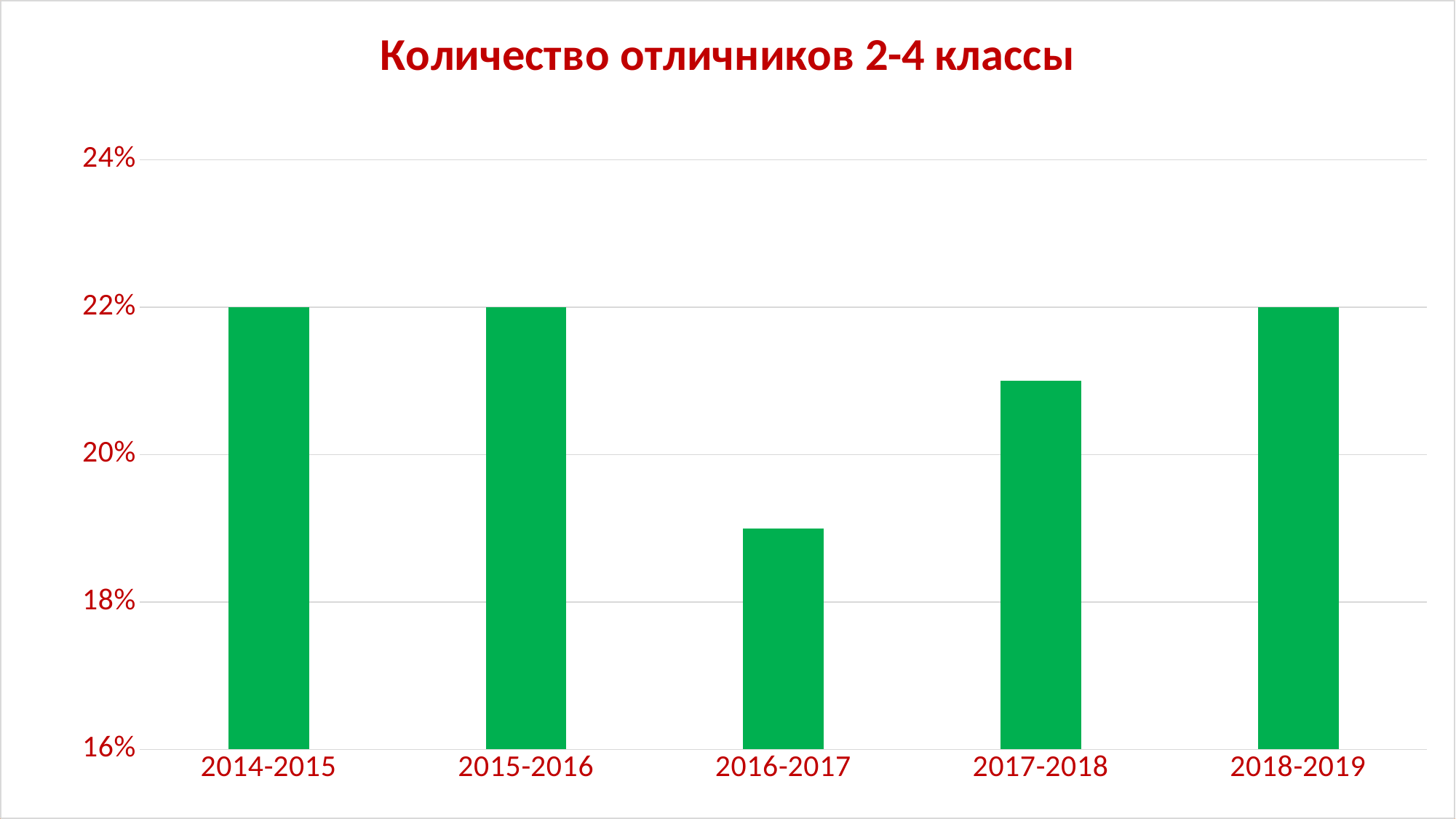
Which school year has the lowest value? 2016-2017 What is the value for 2018-2019? 22% How many school years are shown on the x axis? 5 What is the value for 2015-2016? 22% Which is larger, the value for 2015-2016 or the value for 2016-2017? 2015-2016 Is the value for 2016-2017 greater or less than 20%? less What type of chart is shown on the slide? bar chart Is the value for 2017-2018 greater or less than 22%? less Does the value rise or fall from 2015-2016 to 2016-2017? fall Is the value for 2017-2018 greater or less than 20%? greater What is the value for 2014-2015? 22% What is the title of the chart? Количество отличников 2-4 классы